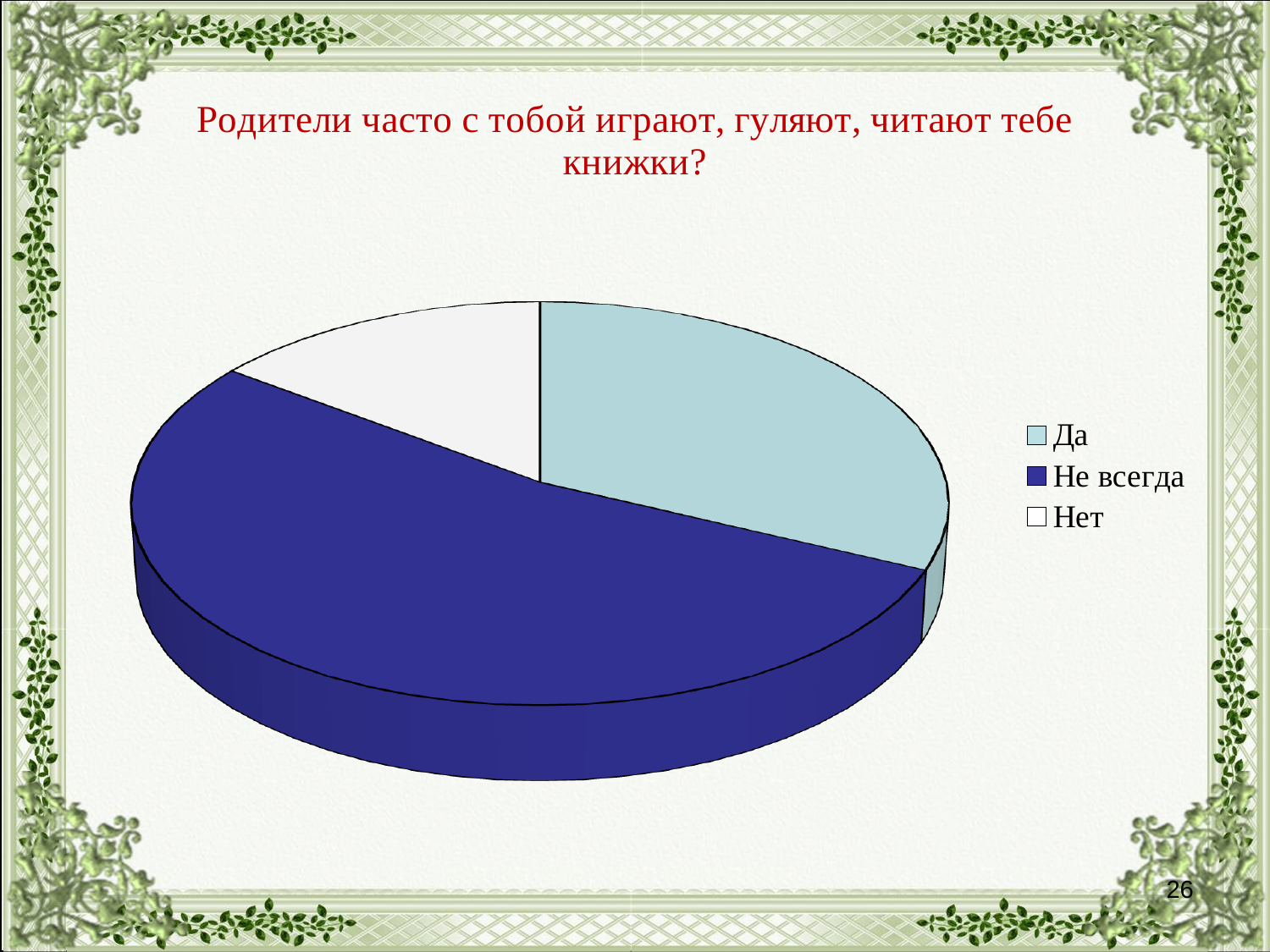
How many entries does the legend list? 3 Which slice is larger, Да or Нет? Да How many slices does the pie chart have? 3 Which slice is larger, Не всегда or Да? Не всегда Which category is shown in dark blue in the legend? Не всегда Which slice is larger, Не всегда or Нет? Не всегда Which category has the largest slice of the pie? Не всегда What kind of chart is shown on the slide? Pie chart What is the title of the chart? Родители часто с тобой играют, гуляют, читают тебе книжки? Which category has the smallest slice of the pie? Нет